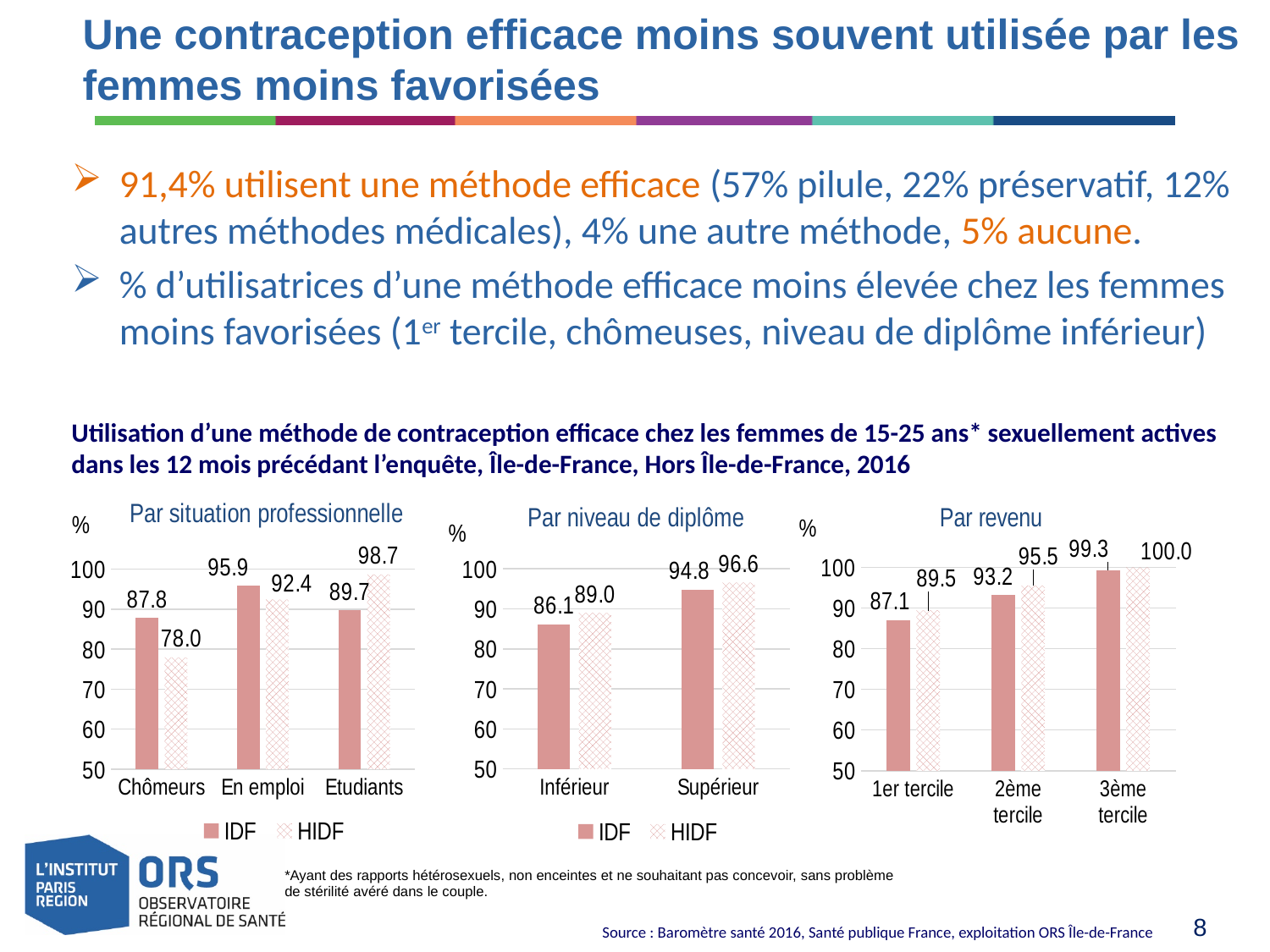
What type of chart is the 'Par revenu' chart? bar chart In the 'Par situation professionnelle' chart, what is the HIDF value for Etudiants? 98.7 In the 'Par revenu' chart, which tercile has the lowest solid (IDF) bar? 1er tercile In the 'Par situation professionnelle' chart, which category has the lowest HIDF value? Chômeurs In the 'Par situation professionnelle' chart, what is the IDF value for Chômeurs? 87.8 In the 'Par revenu' chart, what is the value of the hatched (HIDF) bar for 3ème tercile? 100.0 In the 'Par situation professionnelle' chart, what is the difference between the IDF and HIDF values for Chômeurs? 9.8 In the 'Par niveau de diplôme' chart, which is larger for Inférieur, the IDF value or the HIDF value? HIDF In the 'Par niveau de diplôme' chart, what is the IDF value for Supérieur? 94.8 In the 'Par revenu' chart, do the solid (IDF) bar values rise or fall from 1er tercile to 3ème tercile? rise In the 'Par niveau de diplôme' chart, how many series does the legend list? 2 In the 'Par situation professionnelle' chart, how many categories are shown on the x axis? 3